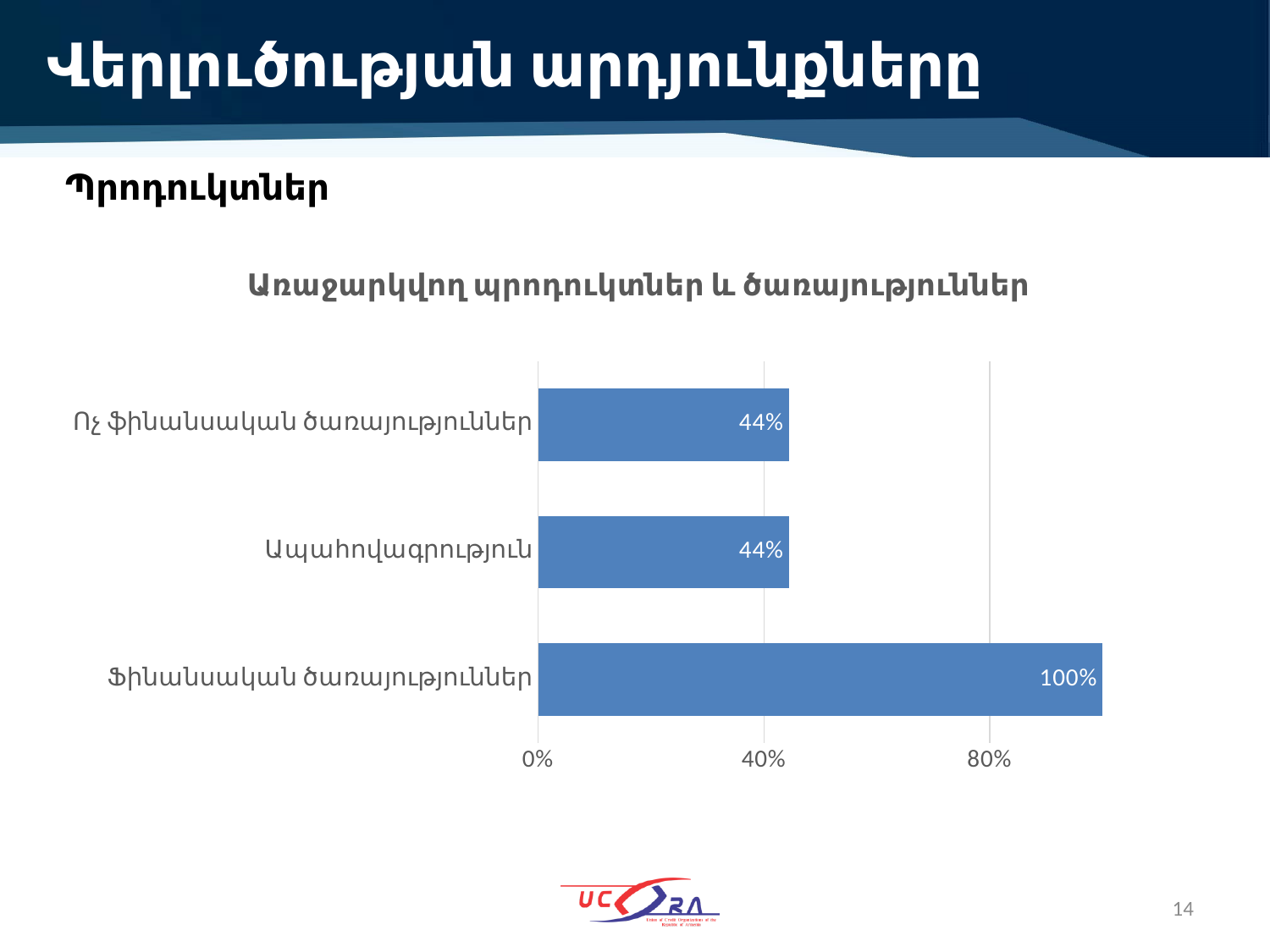
Which category has the highest value? Ֆինանսական ծառայություններ Which is larger, the value for "Ֆինանսական ծառայություններ" or the value for "Ոչ ֆինանսական ծառայություններ"? Ֆինանսական ծառայություններ What is the difference between the values for "Ֆինանսական ծառայություններ" and "Ապահովագրություն"? 56% What value is shown for "Ֆինանսական ծառայություններ"? 100% What value is shown for "Ոչ ֆինանսական ծառայություններ"? 44% How many categories are shown in the chart? 3 What kind of chart is shown on the slide? bar chart What value is shown for "Ապահովագրություն"? 44% Is the value for "Ֆինանսական ծառայություններ" greater or less than 80%? greater What is the title of the chart? Առաջարկվող պրոդուկտներ և ծառայություններ Do "Ոչ ֆինանսական ծառայություններ" and "Ապահովագրություն" have the same value? Yes Is the value for "Ապահովագրություն" greater or less than 80%? less